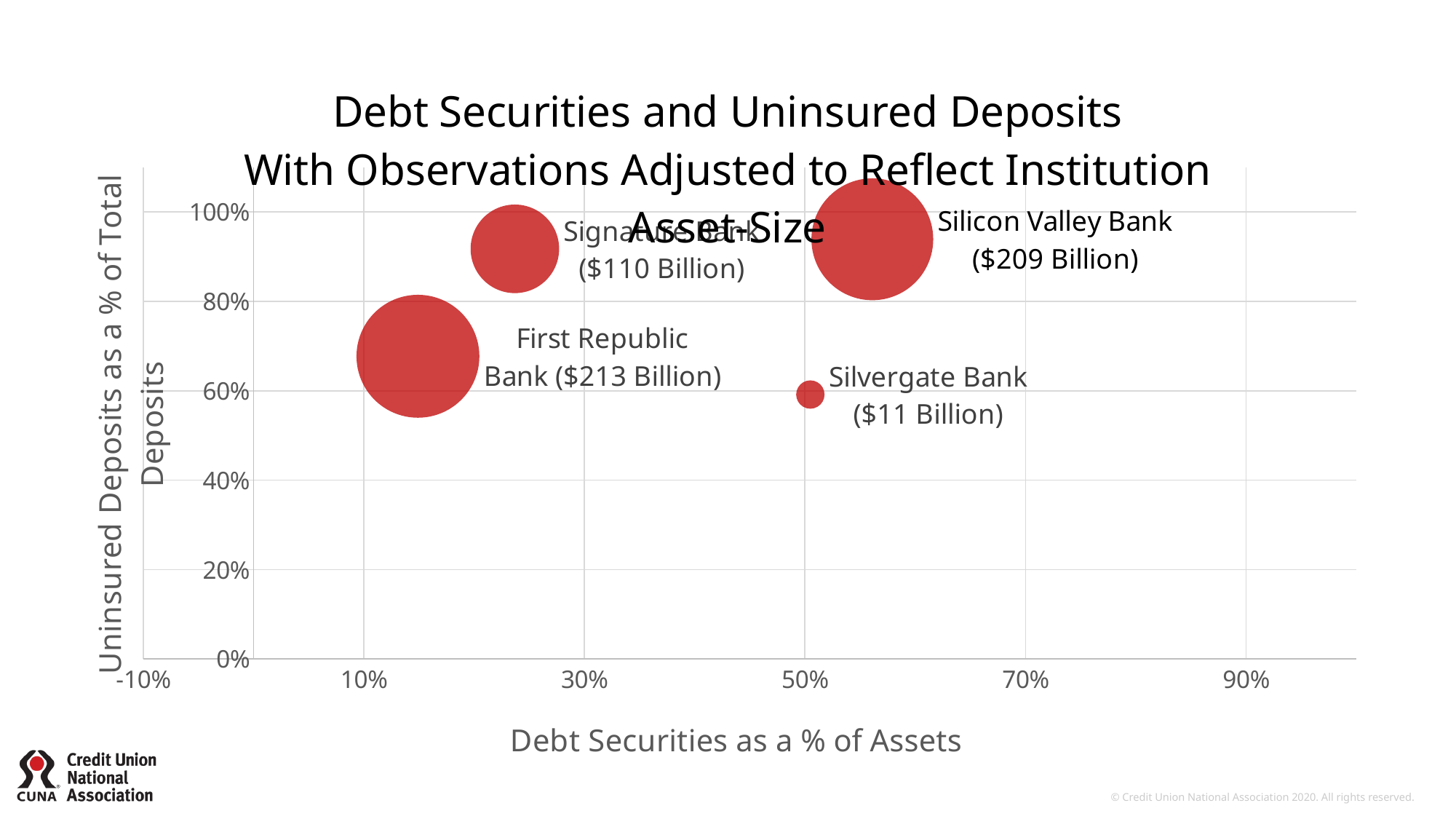
What asset size is shown for Silvergate Bank? $11 Billion What is the difference in asset size between Silicon Valley Bank and Signature Bank? $99 Billion Which bank has a higher uninsured deposits share, Signature Bank or Silvergate Bank? Signature Bank Which bank has the smallest asset size shown on the chart? Silvergate Bank How many banks are plotted on the chart? 4 Is the uninsured deposits share for Silvergate Bank greater or less than 80%? less What asset size is shown for Signature Bank? $110 Billion Which bank has the largest asset size shown on the chart? First Republic Bank What kind of chart is shown on the slide? bubble chart Is the debt securities share for Silicon Valley Bank greater or less than 50%? greater What is the title of the x axis? Debt Securities as a % of Assets What asset size is shown for Silicon Valley Bank? $209 Billion